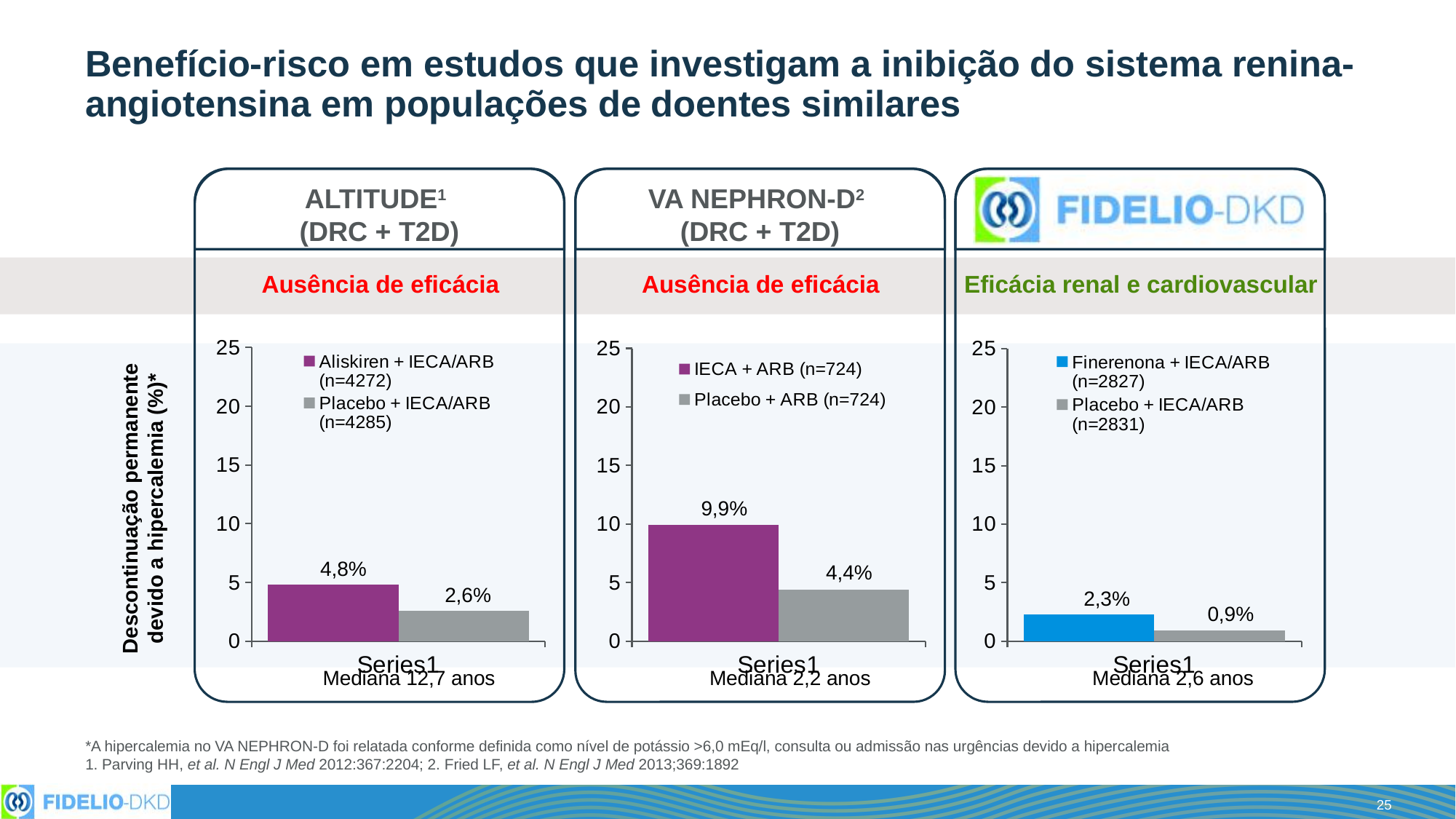
In the FIDELIO-DKD chart, what is the difference between the Finerenona + IECA/ARB value and the Placebo + IECA/ARB value? 1,4% In the ALTITUDE chart, which series has the higher value, Aliskiren + IECA/ARB or Placebo + IECA/ARB? Aliskiren + IECA/ARB How many series does the legend of the FIDELIO-DKD chart list? 2 In the VA NEPHRON-D chart, what is the difference between the IECA + ARB value and the Placebo + ARB value? 5,5% What kind of chart is the ALTITUDE chart? Bar chart In the ALTITUDE chart, what is the value for Aliskiren + IECA/ARB (n=4272)? 4,8% In the FIDELIO-DKD chart, what is the value for Finerenona + IECA/ARB (n=2827)? 2,3% In the VA NEPHRON-D chart, is the value for IECA + ARB greater or less than 5? greater In the FIDELIO-DKD chart, what is the value for Placebo + IECA/ARB (n=2831)? 0,9% In the VA NEPHRON-D chart, what is the value for Placebo + ARB (n=724)? 4,4% In the VA NEPHRON-D chart, what is the value for IECA + ARB (n=724)? 9,9% In the ALTITUDE chart, what is the value for Placebo + IECA/ARB (n=4285)? 2,6%